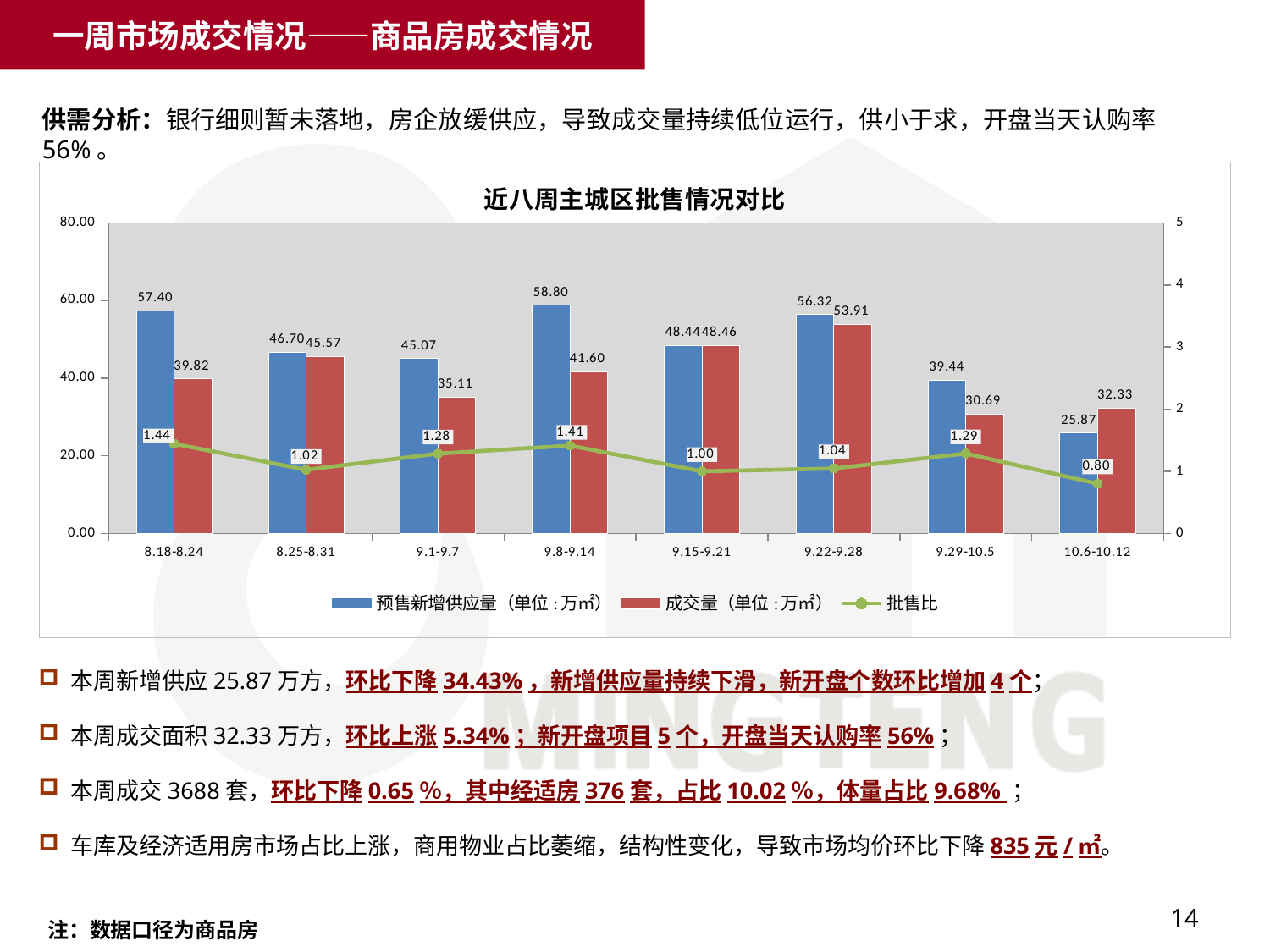
Which week has the lowest 批售比? 10.6-10.12 Does the 预售新增供应量 series rise or fall from 9.22-9.28 to 10.6-10.12? fall How many series does the legend list? 3 What is the title of the chart? 近八周主城区批售情况对比 How many weeks are shown on the x axis? 8 What is the difference between 预售新增供应量 and 成交量 for 8.18-8.24? 17.58 What is the 预售新增供应量 value for 9.8-9.14? 58.80 What is the 成交量 value for 10.6-10.12? 32.33 Which week has the highest 预售新增供应量? 9.8-9.14 What is the 批售比 value for 8.18-8.24? 1.44 Which is larger for 9.22-9.28, 预售新增供应量 or 成交量? 预售新增供应量 Which week has the lowest 成交量? 9.29-10.5